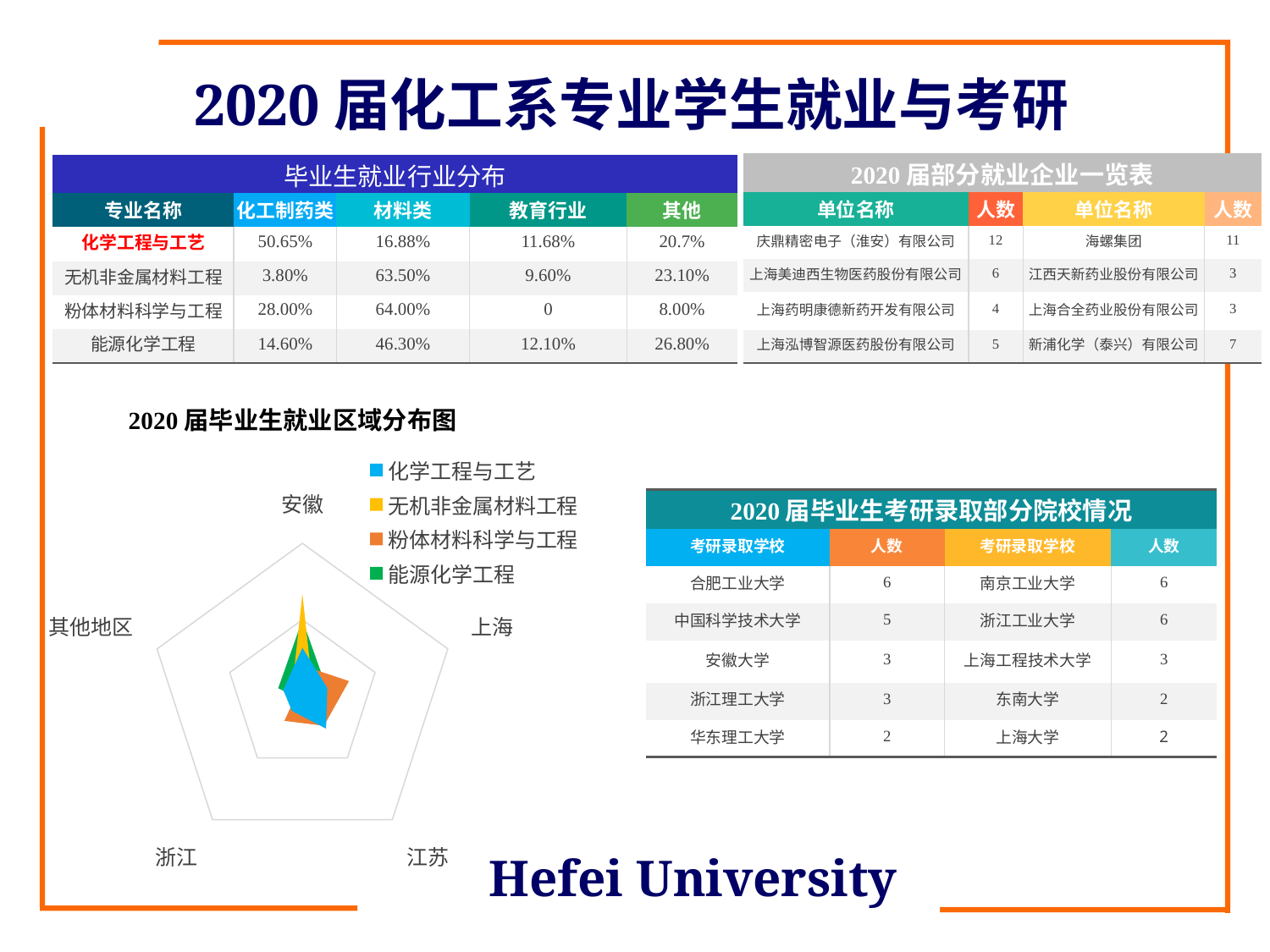
In the radar chart 2020届毕业生就业区域分布图, which series has the larger value for 上海: 化学工程与工艺 or 粉体材料科学与工程? 粉体材料科学与工程 In the radar chart 2020届毕业生就业区域分布图, which series is shown in orange? 粉体材料科学与工程 What is the title of the radar chart on the slide? 2020届毕业生就业区域分布图 How many series does the legend of the radar chart 2020届毕业生就业区域分布图 list? 4 What kind of chart is the 2020届毕业生就业区域分布图? radar chart How many regions (axes) does the radar chart 2020届毕业生就业区域分布图 have? 5